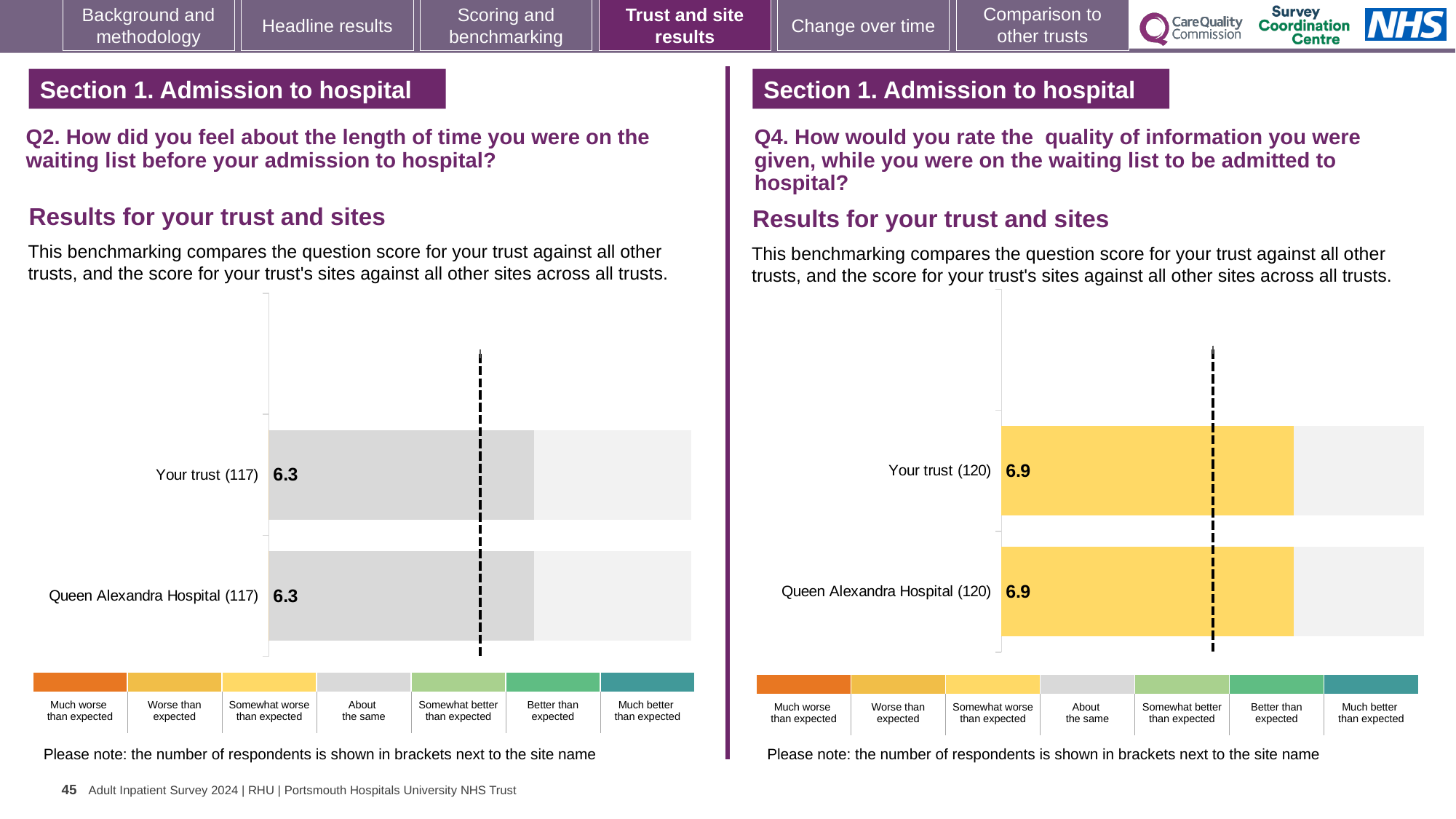
What kind of chart is the Q2 chart on the left? Bar chart How many bars are plotted in the Q4 chart on the right? 2 In the Q2 chart on the left, what is the score for Queen Alexandra Hospital? 6.3 How many bars are plotted in the Q2 chart on the left? 2 In the Q2 chart on the left, how many respondents are shown in brackets for Your trust? 117 In the Q4 chart on the right, what is the score for Queen Alexandra Hospital? 6.9 In the Q4 chart on the right, what is the score for Your trust? 6.9 In the Q4 chart on the right, which benchmark category does the yellow colour of the bars correspond to in the legend? Somewhat worse than expected In the Q2 chart on the left, what is the score for Your trust? 6.3 In the Q4 chart on the right, what is the difference between the score for Your trust and the score for Queen Alexandra Hospital? 0 In the Q4 chart on the right, how many respondents are shown in brackets for Queen Alexandra Hospital? 120 In the Q2 chart on the left, what is the difference between the score for Your trust and the score for Queen Alexandra Hospital? 0